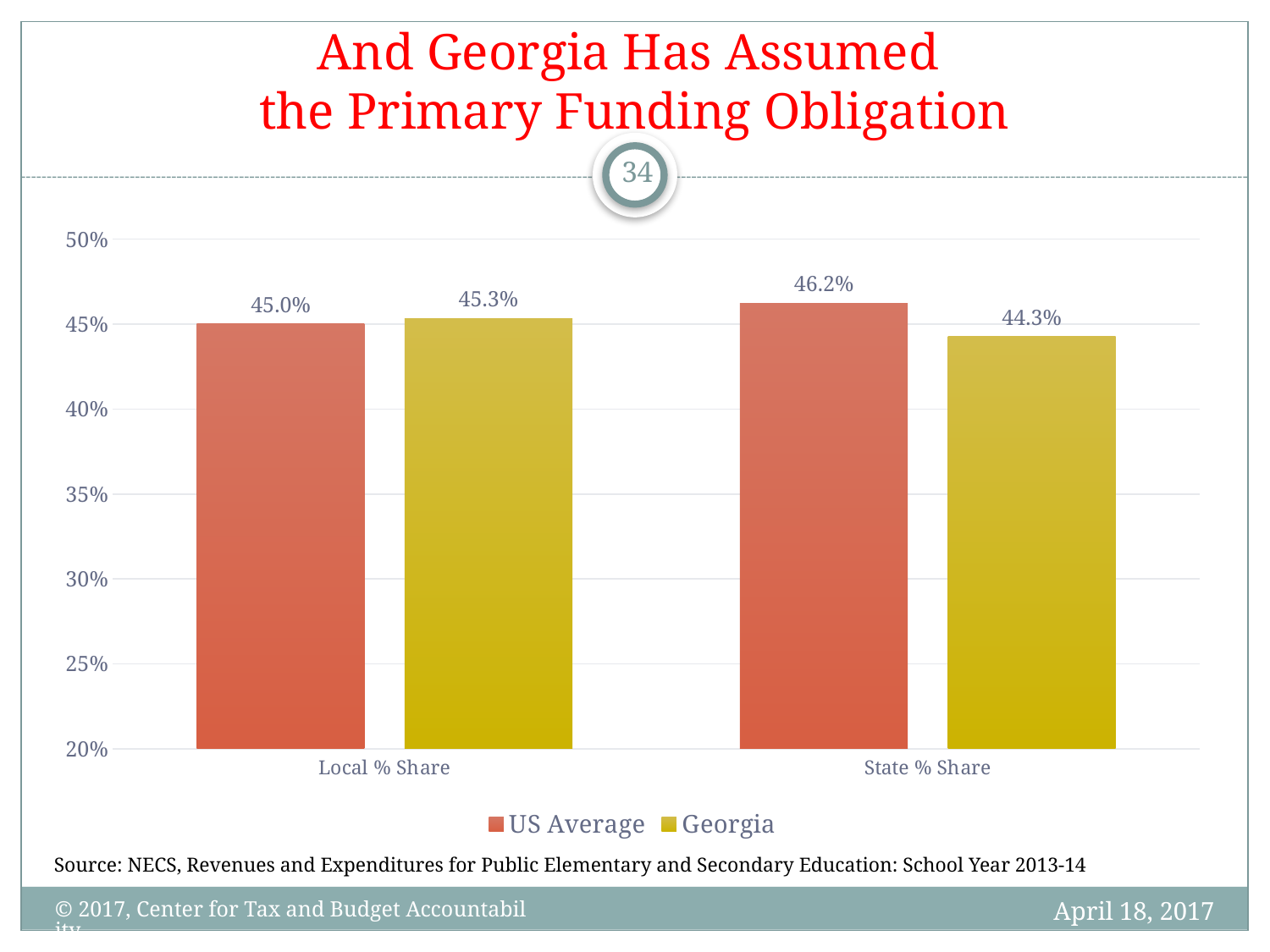
What is the US Average value for State % Share? 46.2% What kind of chart is shown on the slide? Bar chart How many categories are shown on the x axis? 2 What is the Georgia value for Local % Share? 45.3% Which bar has the lowest value on the chart? Georgia, State % Share For State % Share, which is larger: US Average or Georgia? US Average What is the US Average value for Local % Share? 45.0% What is the difference between the US Average and Georgia values for State % Share? 1.9% How many series does the legend list? 2 Which bar has the highest value on the chart? US Average, State % Share What is the Georgia value for State % Share? 44.3% What is the difference between the Georgia and US Average values for Local % Share? 0.3%